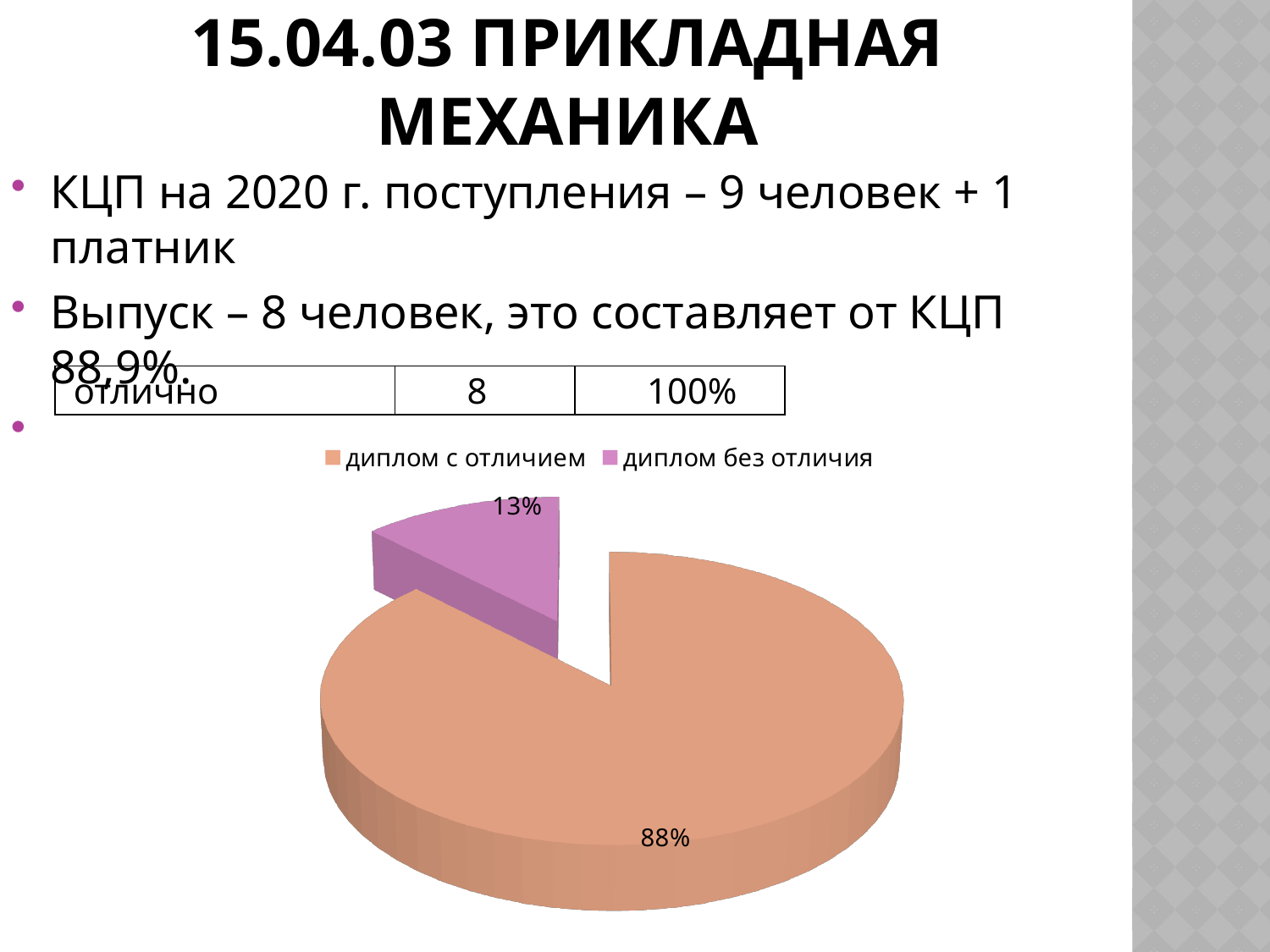
Where is the legend positioned relative to the pie? above the pie What colour is the "диплом без отличия" slice? purple Is the share for "диплом с отличием" greater or less than 50%? greater How many entries does the legend list? 2 What kind of chart is shown on the slide? pie chart Which slice of the pie is the smallest? диплом без отличия How many slices does the pie chart have? 2 Which is larger: the share for "диплом с отличием" or the share for "диплом без отличия"? диплом с отличием What share of the pie does "диплом без отличия" represent? 13% Which slice of the pie is the largest? диплом с отличием What is the difference in percentage points between the "диплом с отличием" slice and the "диплом без отличия" slice? 75 What share of the pie does "диплом с отличием" represent? 88%